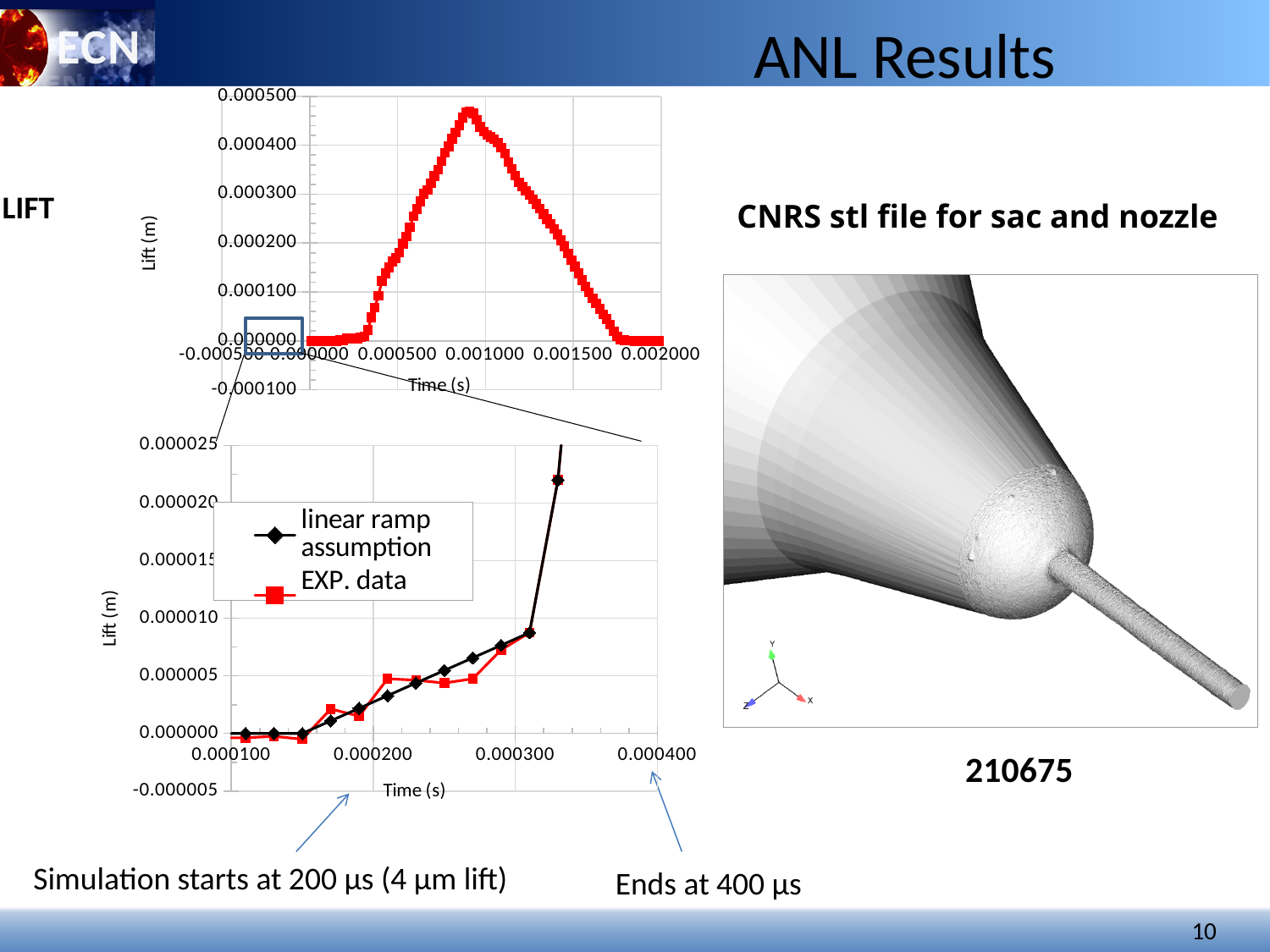
In the bottom chart, does the lift generally rise or fall as time increases from 0.000100 to 0.000330? rise How many series does the legend of the bottom chart list? 2 What is the x-axis label of the bottom chart? Time (s) In the top chart, is the peak lift value greater or less than 0.000400? greater In the bottom chart, is the lift at time 0.000200 greater or less than 0.000005? less In the top chart, does the lift rise or fall between time 0.001000 and 0.001500? fall What are the two series named in the legend of the bottom chart? linear ramp assumption; EXP. data What kind of chart is the top chart? line chart What is the highest tick value shown on the y-axis of the top chart? 0.000500 In the top chart, does the lift rise or fall between time 0.000500 and 0.001000? rise In the bottom chart, is the EXP. data lift at the last plotted point (around time 0.000330) greater or less than 0.000015? greater